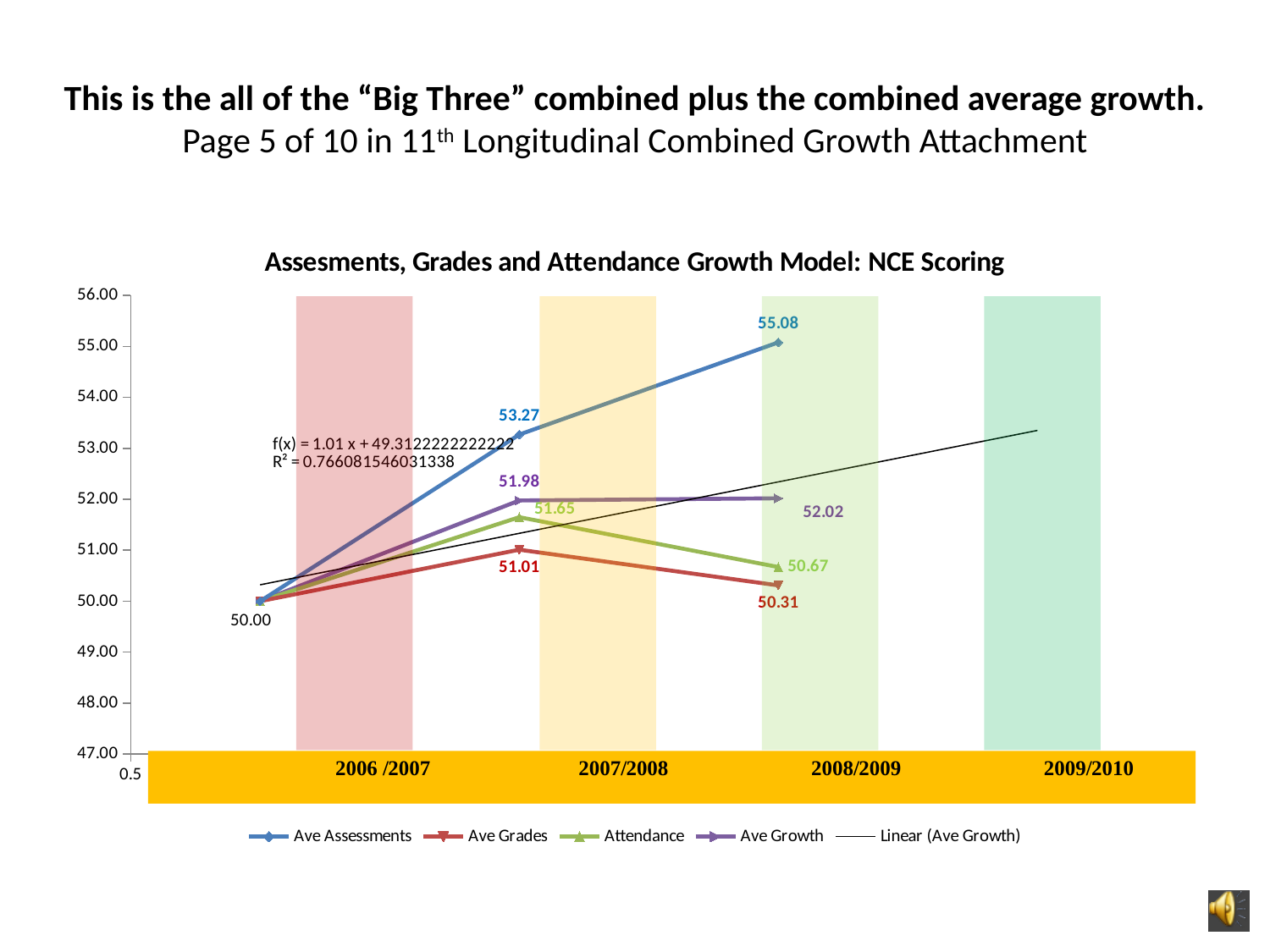
Which series has the highest final plotted value? Ave Assessments What is the difference between the final Ave Assessments value (55.08) and the final Ave Grades value (50.31)? 4.77 Does the Ave Grades series rise or fall between its second and third plotted points? fall What is the final (third) plotted value for Ave Assessments? 55.08 What is the second plotted value for Ave Grades? 51.01 What is the second plotted value for Ave Growth? 51.98 Is the final plotted value for Ave Growth greater or less than 52.00? greater What is the final (third) plotted value for Attendance? 50.67 What is the title of the chart? Assesments, Grades and Attendance Growth Model: NCE Scoring How many series does the chart legend list? 5 Which series has the lowest final plotted value? Ave Grades What type of chart is shown on the slide? line chart